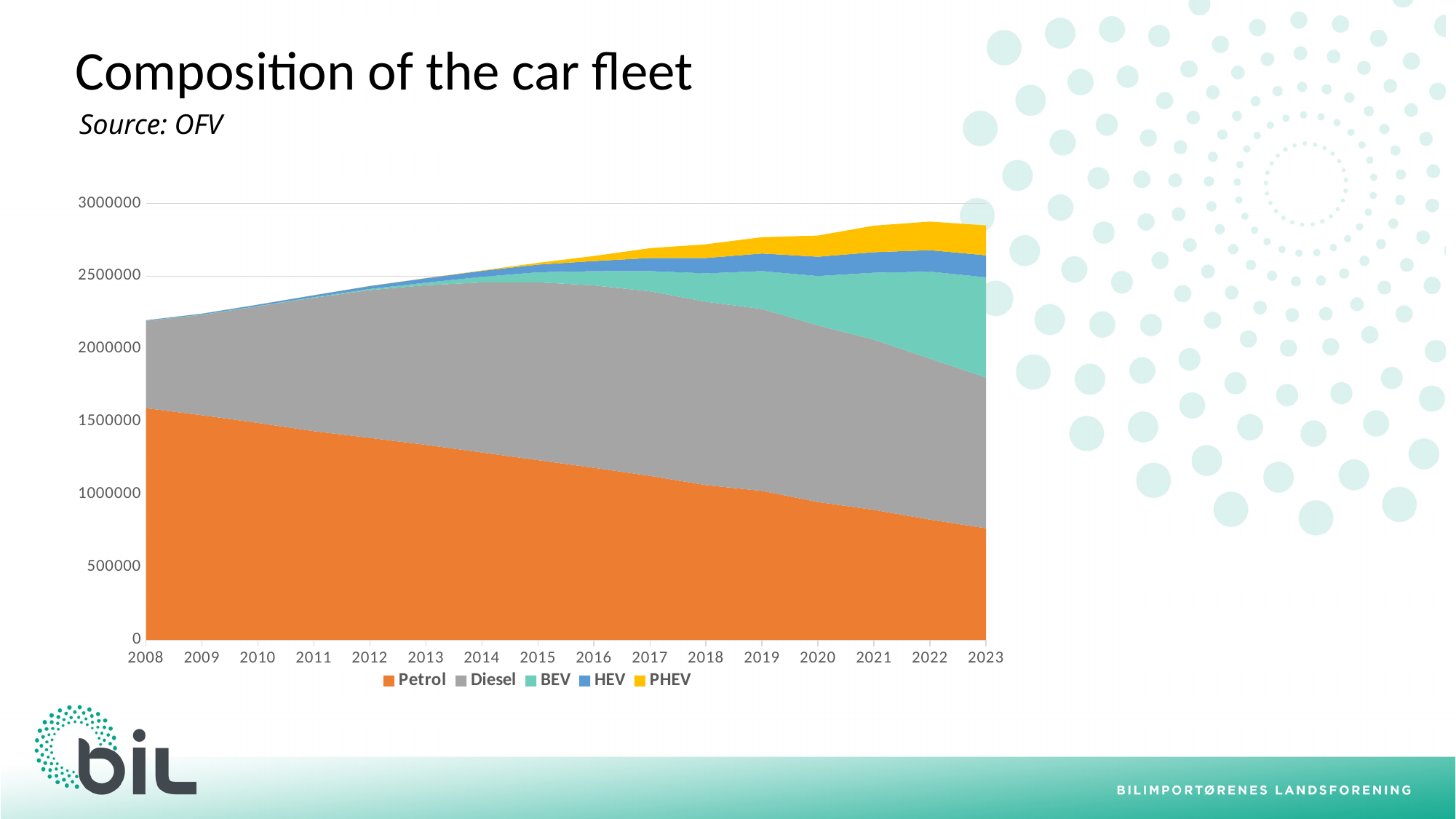
Is the total of all series in 2023 greater or less than 3000000? less Which series is listed first in the legend? Petrol Is the value for Petrol in 2023 greater or less than 1000000? less Does the total height of the stacked areas rise or fall from 2008 to 2023? Rise What is the source given for the chart? OFV What kind of chart is shown on the slide? Stacked area chart In 2023, which is larger, the Petrol area or the Diesel area? Diesel How many years are shown along the x axis? 16 Does the Petrol area rise or fall from 2008 to 2023? Fall Which series has the largest value in 2008? Petrol How many series does the legend list? 5 Is the value for Petrol in 2008 greater or less than 1500000? greater